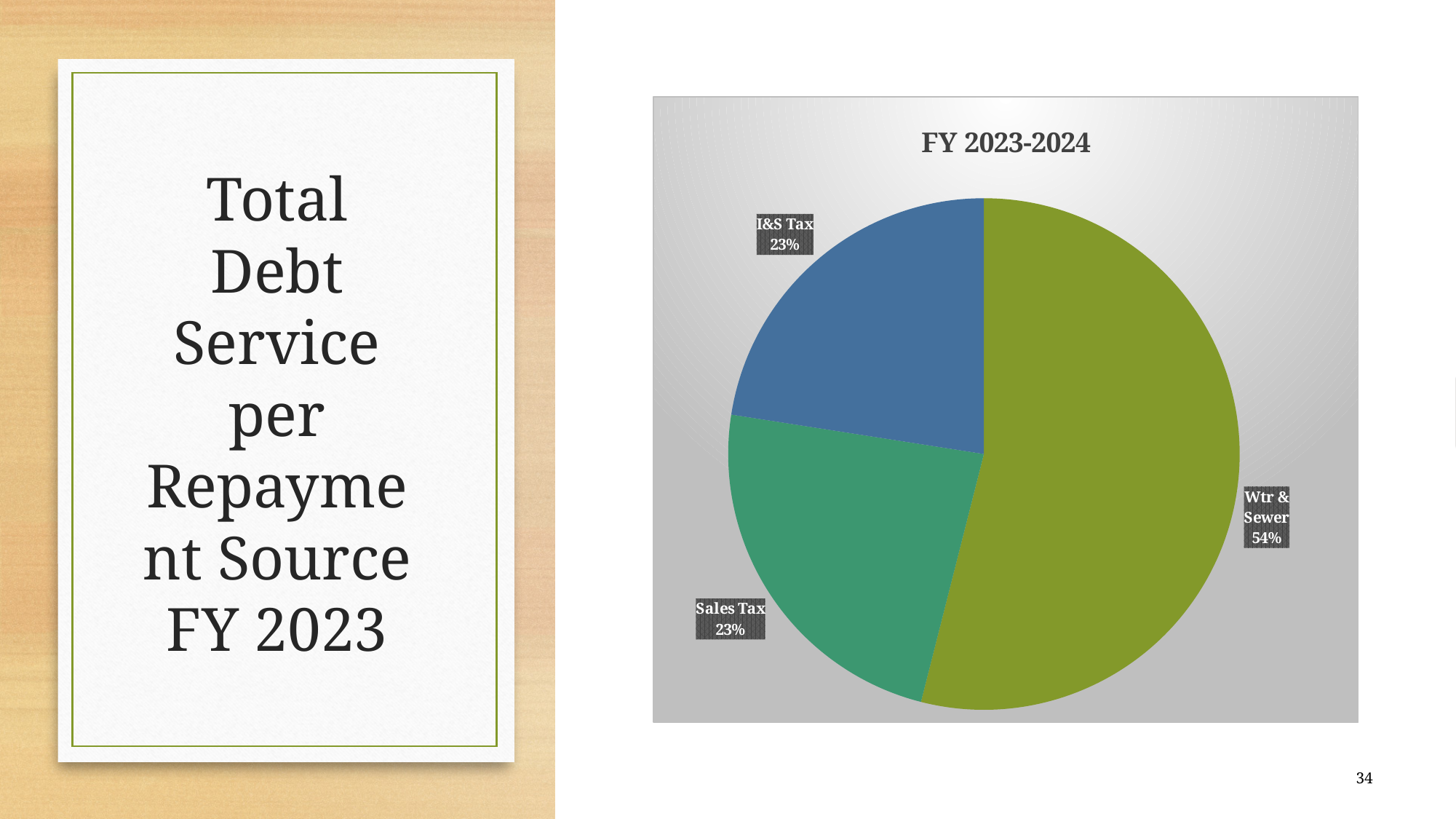
How many slices does the pie chart have? 3 Is the Wtr & Sewer share greater or less than 50%? greater What share of the pie does Wtr & Sewer represent? 54% Which repayment source has the largest share of the pie? Wtr & Sewer What colour is the Wtr & Sewer slice? Green What is the difference in percentage points between the Wtr & Sewer share and the Sales Tax share? 31 What type of chart is shown on the slide? Pie chart Which is larger, the Wtr & Sewer share or the I&S Tax share? Wtr & Sewer What share of the pie does I&S Tax represent? 23% What share of the pie does Sales Tax represent? 23% What is the combined share of I&S Tax and Sales Tax? 46% What is the title of the chart? FY 2023-2024